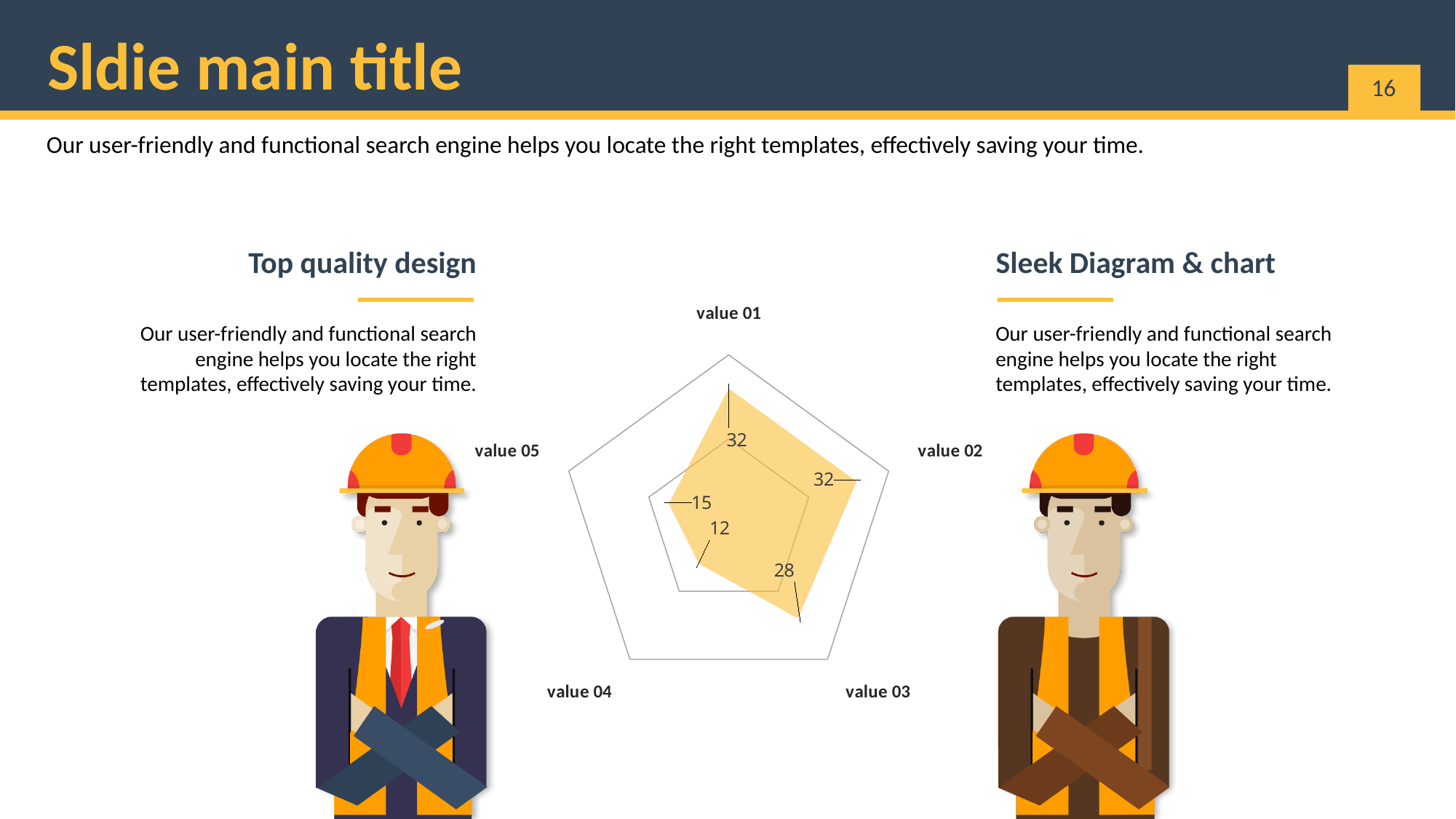
Which is larger, the value for value 05 or the value for value 04? value 05 What is the value for value 01? 32 Which is larger, the value for value 03 or the value for value 05? value 03 What is the value for value 03? 28 What is the value for value 04? 12 What is the value for value 05? 15 What is the difference between the values for value 01 and value 05? 17 What type of chart is shown on the slide? radar chart What is the difference between the values for value 03 and value 04? 16 How many categories does the radar chart have? 5 Which category has the lowest value? value 04 What is the value for value 02? 32